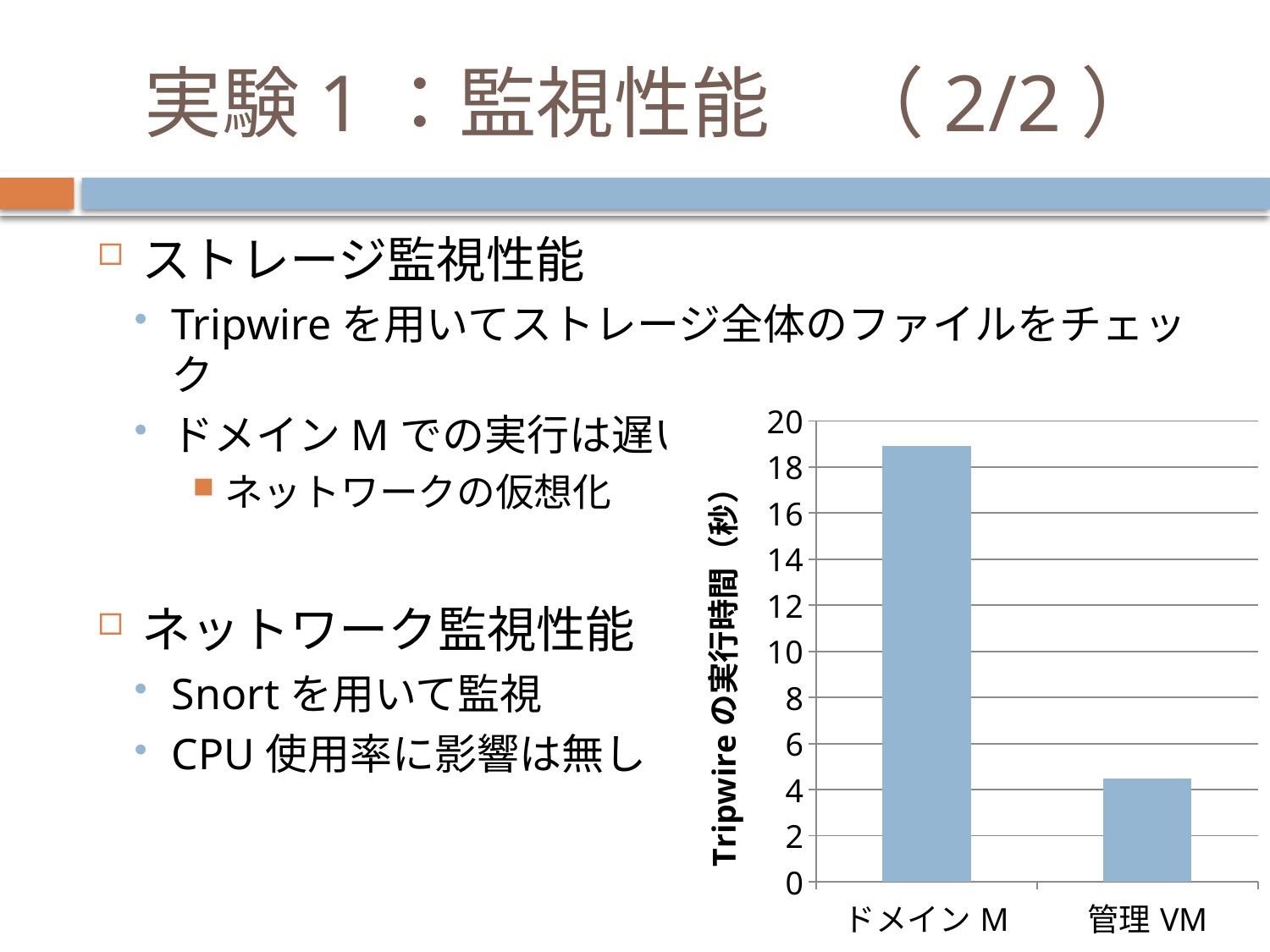
What is the label of the y axis of the chart? Tripwire の実行時間（秒） Is the value for ドメイン M greater or less than 16? greater Which has a larger value, ドメイン M or 管理 VM? ドメイン M Which category has the highest Tripwire execution time? ドメイン M Which category has the lowest Tripwire execution time? 管理 VM How many categories are plotted on the x axis of the chart? 2 Is the value for ドメイン M greater or less than 20? less Is the value for 管理 VM greater or less than 10? less What is the highest tick value shown on the y axis of the chart? 20 What kind of chart is shown on the slide? bar chart